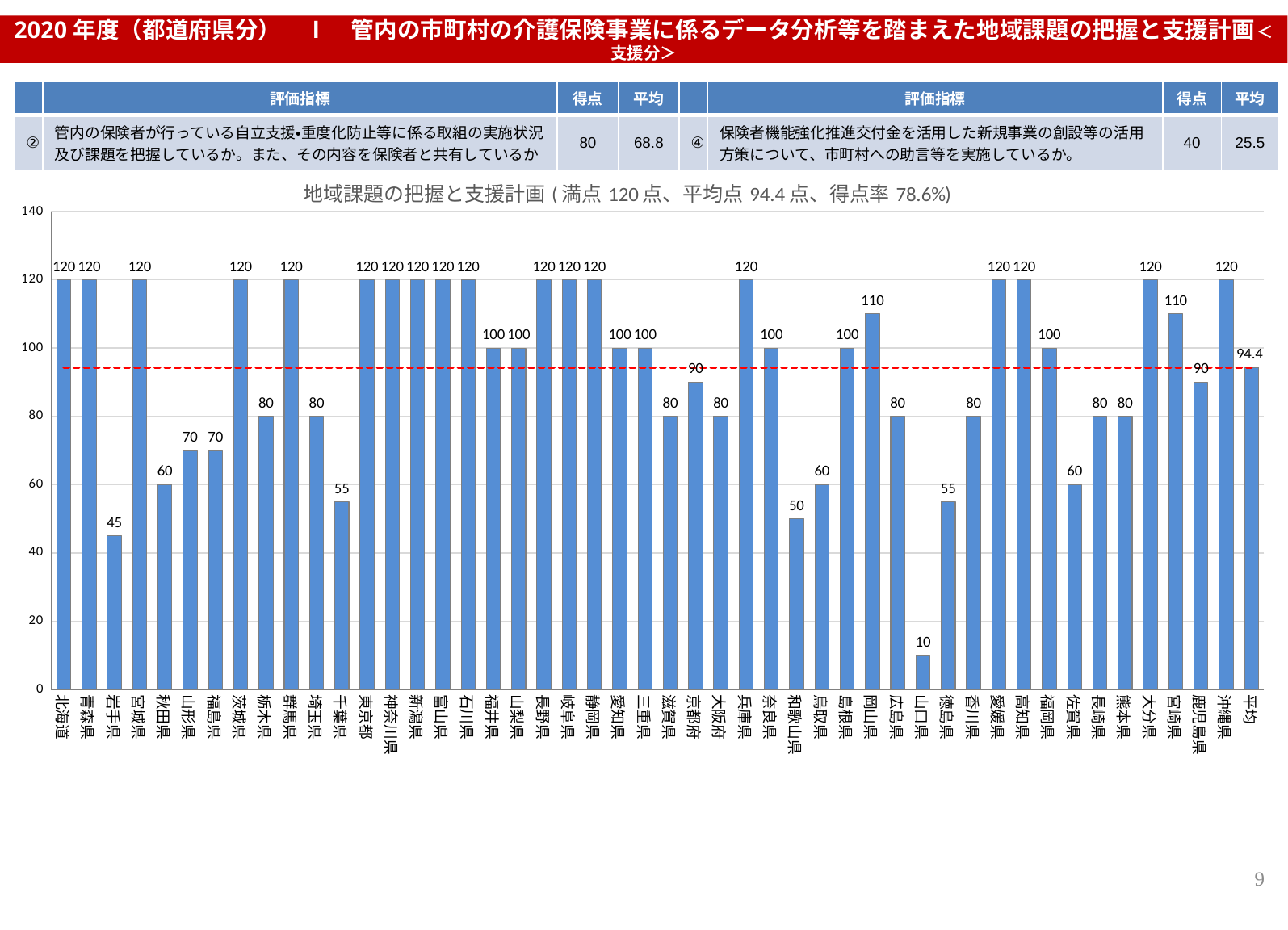
How many bars are plotted in the chart? 48 What is the value for 岡山県? 110 What is the value for 鹿児島県? 90 What is the value for 平均? 94.4 What is the difference between the values for 北海道 and 岩手県? 75 What is the value for 岩手県? 45 What is the difference between the values for 岡山県 and 和歌山県? 60 What kind of chart is shown on the slide? Bar chart What is the title of the chart? 地域課題の把握と支援計画 ( 満点 120 点、平均点 94.4 点、得点率 78.6%) What is the value for 山口県? 10 Which is larger, the value for 千葉県 or the value for 秋田県? 秋田県 Which category has the lowest value? 山口県